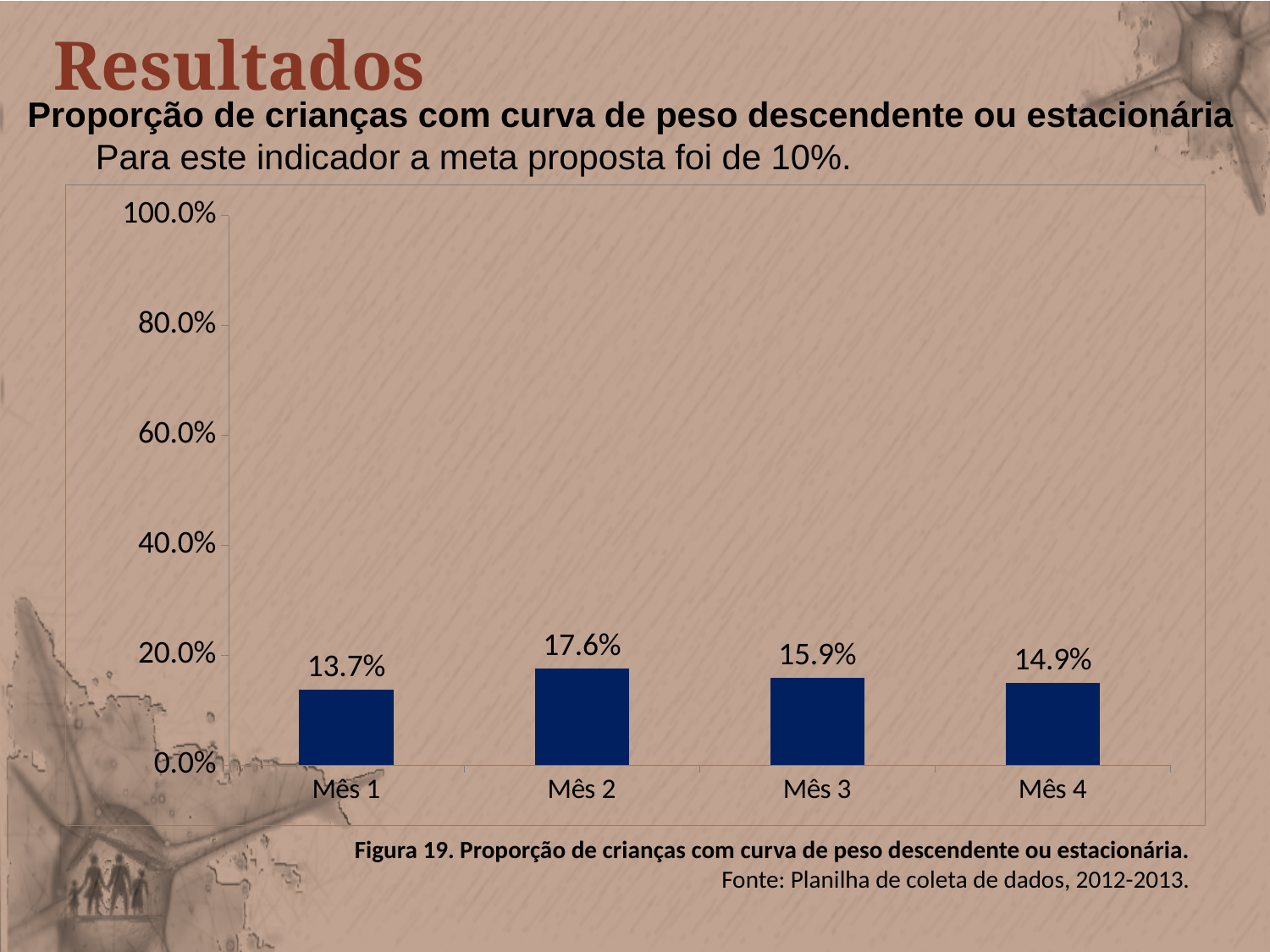
Which month has the highest value? Mês 2 What is the difference between the values for Mês 2 and Mês 1? 3.9% How many months are shown on the x axis? 4 Is the value for Mês 2 greater or less than 20.0%? less What is the value for Mês 2? 17.6% What is the value for Mês 1? 13.7% What is the value for Mês 4? 14.9% Which month has the lowest value? Mês 1 What kind of chart is shown on the slide? bar chart What is the figure caption below the chart? Figura 19. Proporção de crianças com curva de peso descendente ou estacionária. What is the value for Mês 3? 15.9% Which is larger, the value for Mês 3 or the value for Mês 4? Mês 3